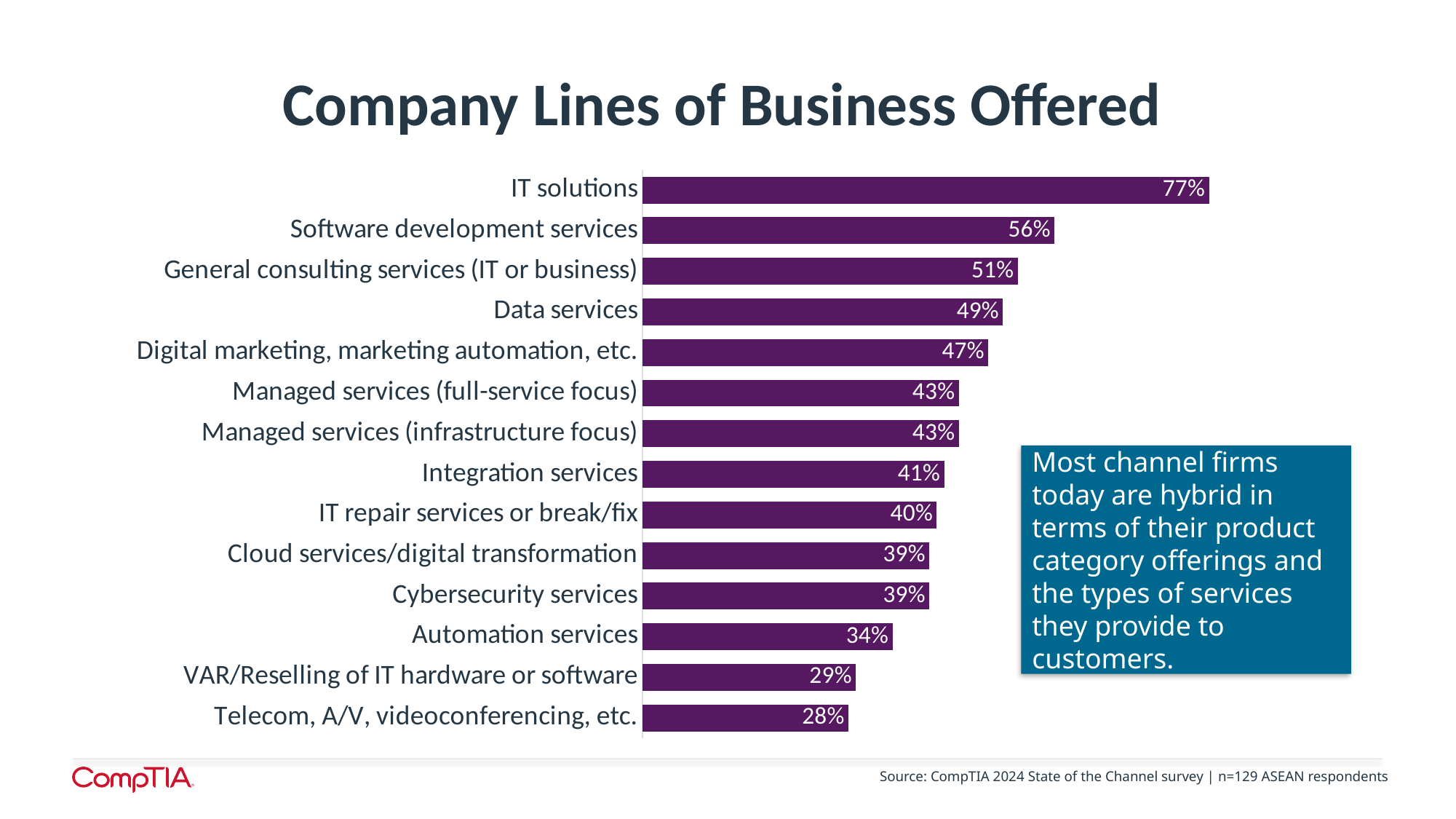
Which is larger, Integration services or Cloud services/digital transformation? Integration services Which line of business has the highest percentage? IT solutions Which is larger, General consulting services (IT or business) or Digital marketing, marketing automation, etc.? General consulting services (IT or business) What is the difference between IT solutions and Software development services? 21 percentage points What is the value for Cybersecurity services? 39% What percentage of companies offer IT solutions? 77% Which line of business has the lowest percentage? Telecom, A/V, videoconferencing, etc. What is the title of the chart? Company Lines of Business Offered What is the difference between Data services and Automation services? 15 percentage points How many lines of business are shown in the chart? 14 What type of chart is shown on the slide? Bar chart What percentage is shown for VAR/Reselling of IT hardware or software? 29%